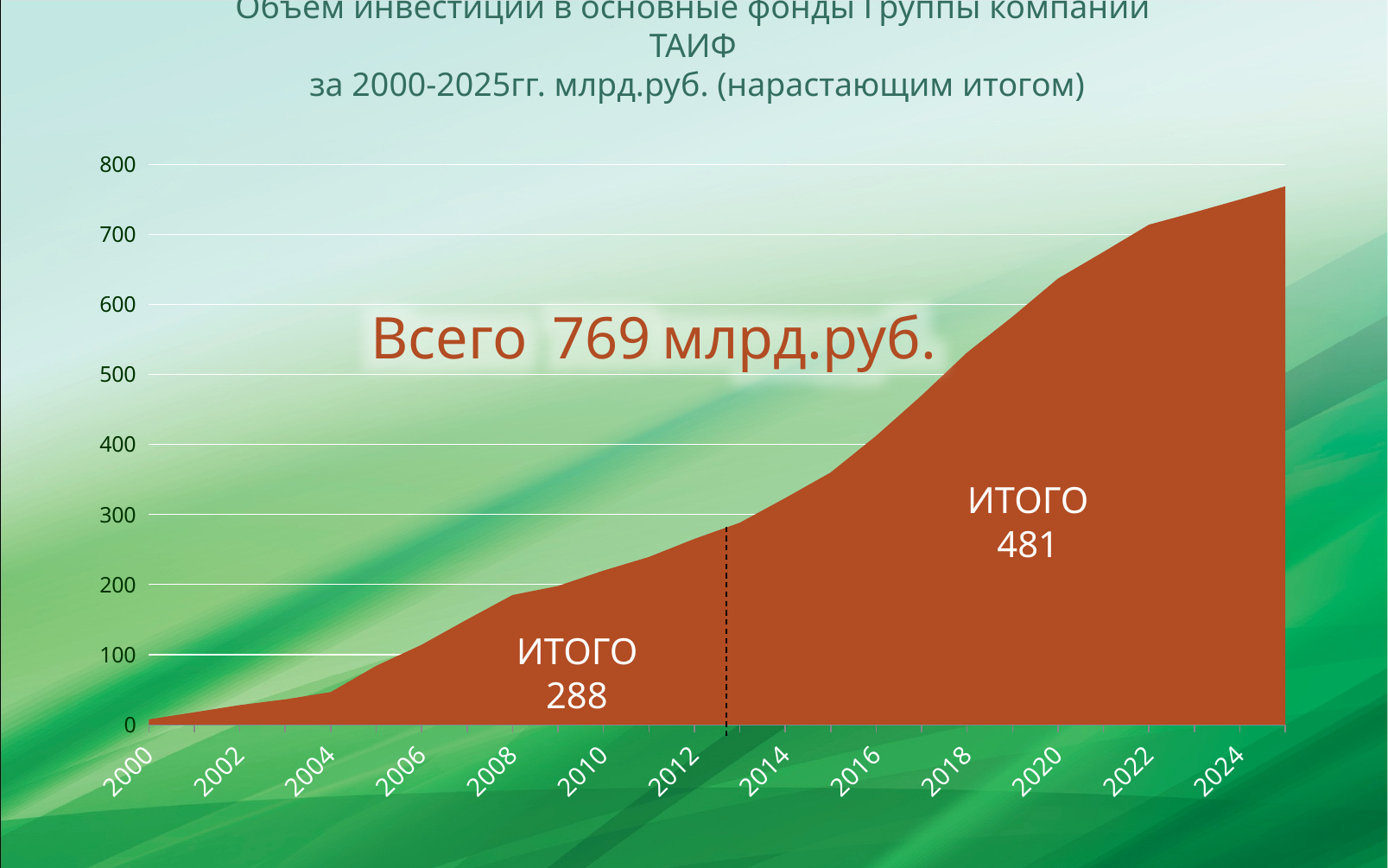
Which of the two 'ИТОГО' labels is larger, 288 or 481? 481 What kind of chart is shown on the slide? area chart How many year labels are shown on the x axis? 13 What total value is printed in the large label on the chart? 769 млрд.руб. Is the value for 2018 greater or less than 500? greater Is the value for 2012 greater or less than 300? less Is the value for 2004 greater or less than 100? less Do the values rise or fall along the x axis from 2000 to 2024? rise What is the highest value shown on the y axis? 800 What is the value of the 'ИТОГО' label on the left part of the chart (before the dashed line)? 288 What is the difference between the two 'ИТОГО' values, 481 and 288? 193 What is the value of the 'ИТОГО' label on the right part of the chart (after the dashed line)? 481